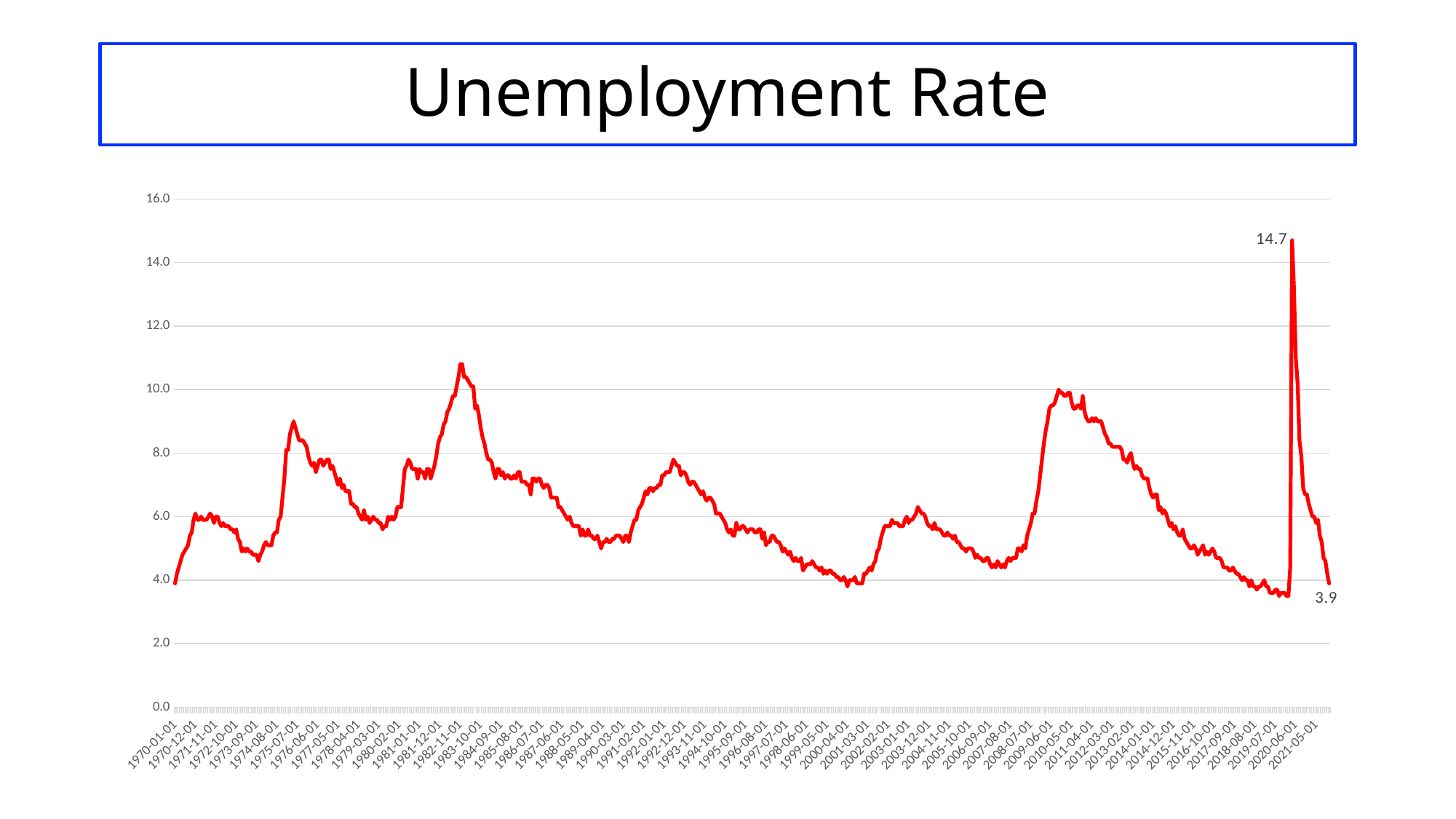
What is the highest value labelled on the line? 14.7 Is the value just before the 2020 spike greater or less than 4.0? less After the 14.7 peak, does the line rise or fall toward the end of the chart? fall What is the difference between the labelled peak value and the labelled final value? 10.8 What is the title of the chart? Unemployment Rate Is the peak value around 1975 greater or less than 8.0? greater What colour is the line in the chart? red In which year does the line reach its highest value? 2020 What is the value labelled at the end of the line (the last data point)? 3.9 Which peak is higher, the one around 1983 or the one around 1975? 1983 What kind of chart is shown on the slide? line chart Is the peak value around 1983 greater or less than 10.0? greater